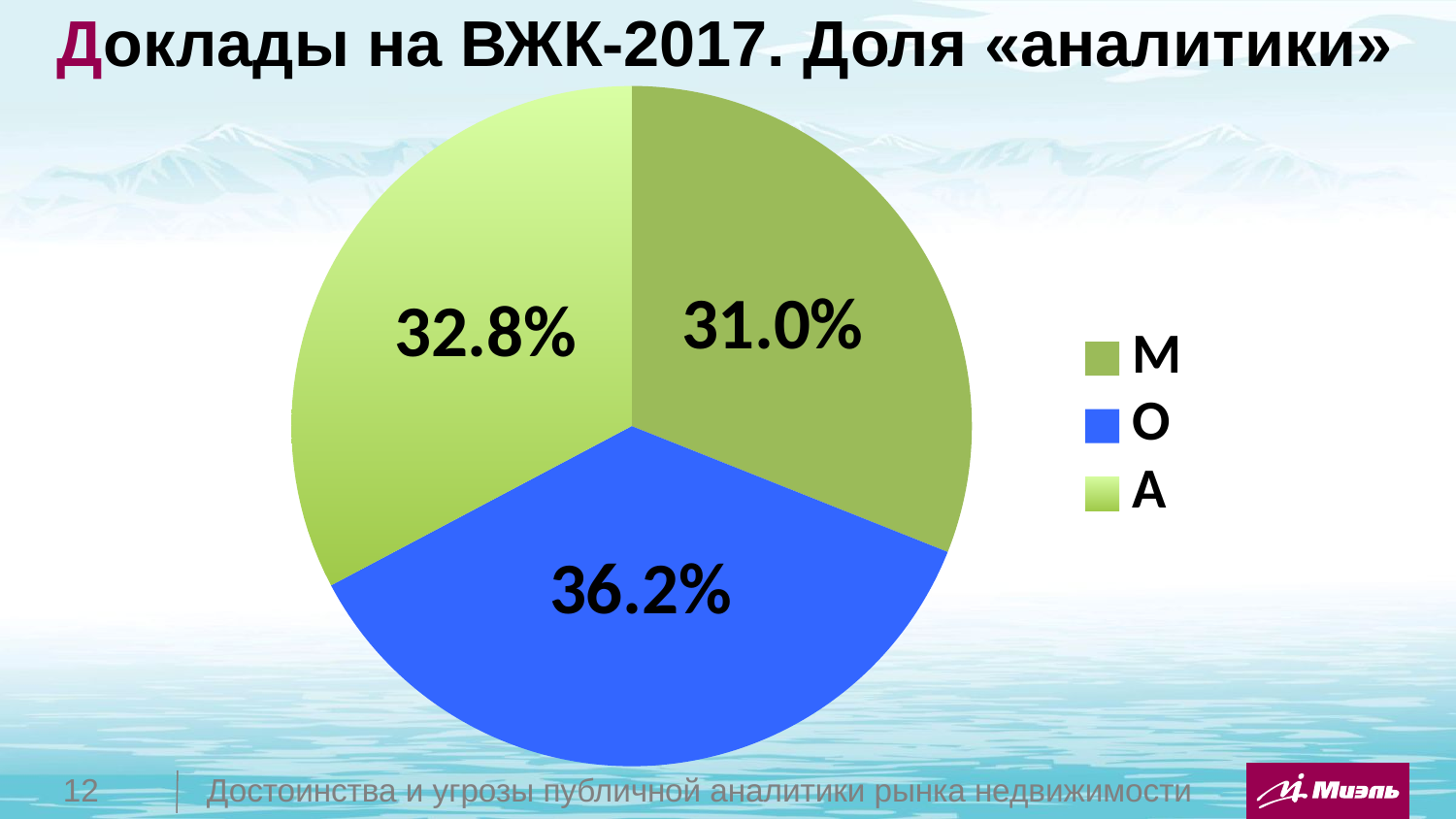
What is the difference between the shares of А and М? 1.8% What share of the pie does category О have? 36.2% Which category has the largest share of the pie? О Which has a larger share, О or А? О What colour is the slice for category О? Blue What share of the pie does category А have? 32.8% What kind of chart is shown on the slide? Pie chart What share of the pie does category М have? 31.0% Which category has the smallest share of the pie? М How many entries does the legend list? 3 What is the difference between the shares of О and М? 5.2% How many slices does the pie chart have? 3